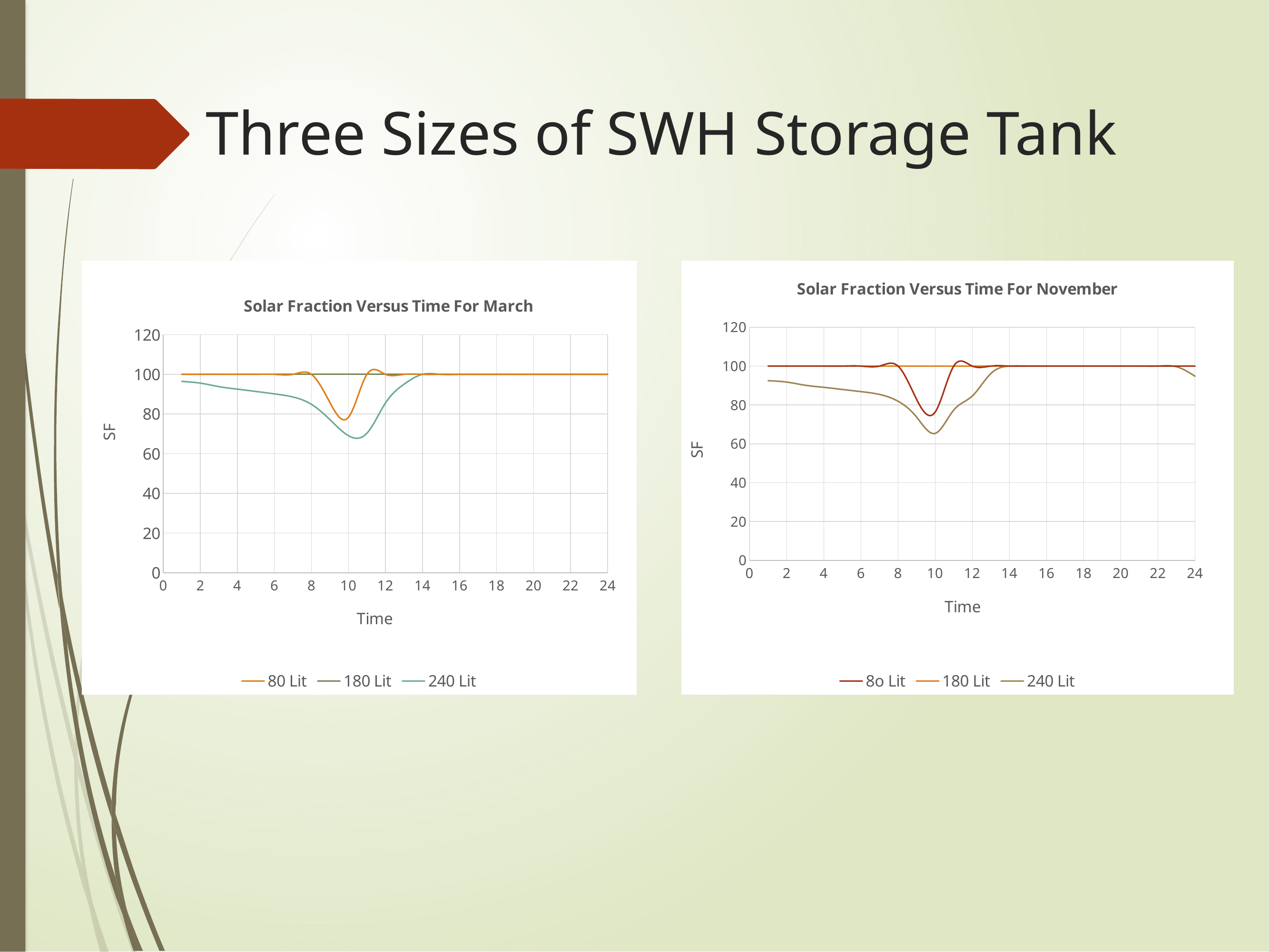
In the "Solar Fraction Versus Time For November" chart, is the lowest value of the 240 Lit series greater or less than 80? less In the "Solar Fraction Versus Time For November" chart, is the lowest value of the 80 Lit series greater or less than 60? greater In the "Solar Fraction Versus Time For November" chart, which series reaches the lowest value? 240 Lit What kind of chart is the "Solar Fraction Versus Time For March" chart? line chart In the "Solar Fraction Versus Time For March" chart, is the lowest value of the 80 Lit series greater or less than 60? greater In the "Solar Fraction Versus Time For March" chart, which series dips lower around time 10: 80 Lit or 240 Lit? 240 Lit In the "Solar Fraction Versus Time For March" chart, which series reaches the lowest value? 240 Lit What is the y-axis label of the "Solar Fraction Versus Time For March" chart? SF In the "Solar Fraction Versus Time For November" chart, does the 240 Lit series rise or fall between time 2 and time 10? fall What is the title of the chart on the right side of the slide? Solar Fraction Versus Time For November How many series does the legend of the "Solar Fraction Versus Time For November" chart list? 3